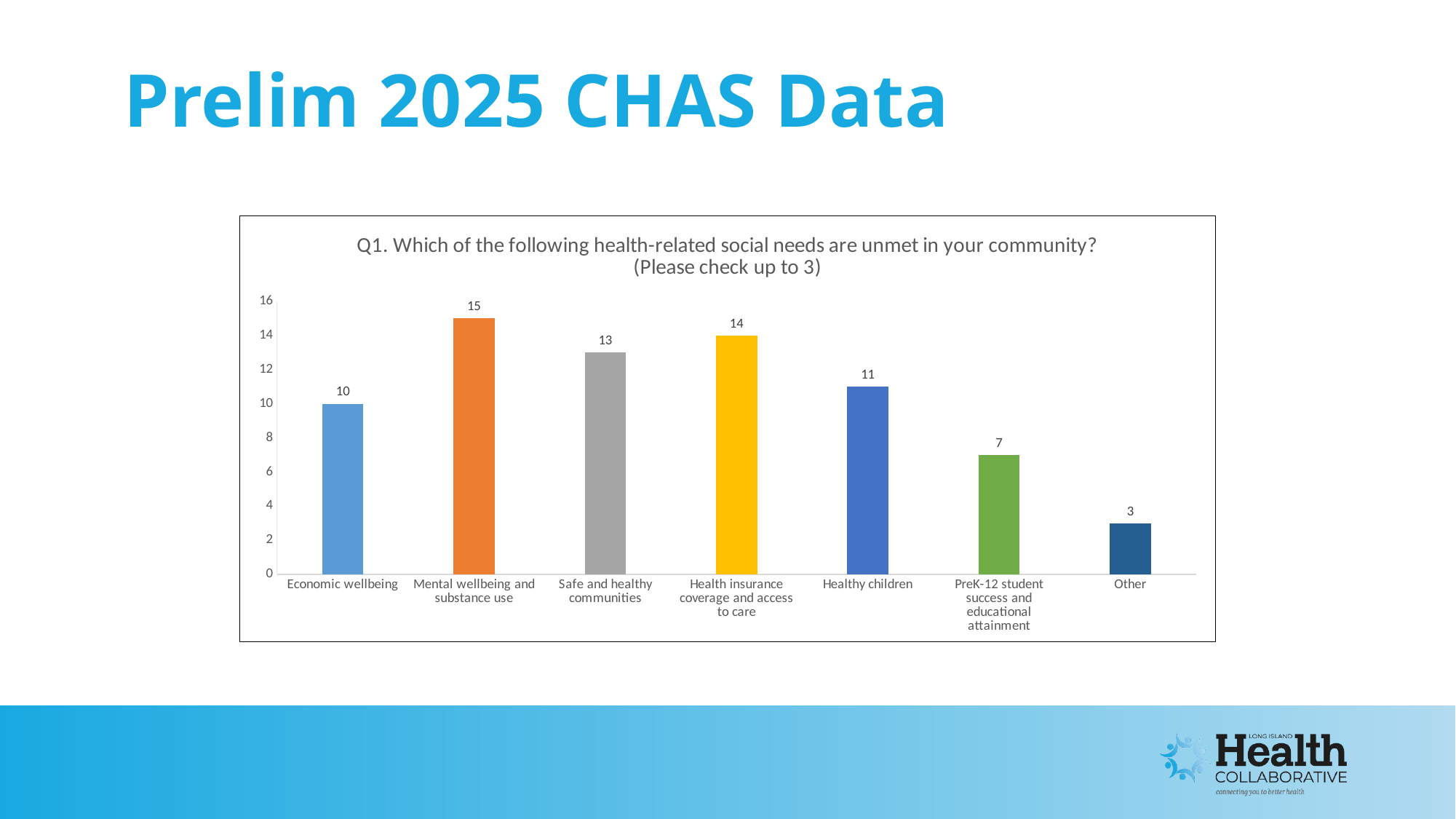
What is the value for Economic wellbeing? 10 What is the value for Mental wellbeing and substance use? 15 What is the title of the chart? Q1. Which of the following health-related social needs are unmet in your community? (Please check up to 3) What kind of chart is shown on the slide? Bar chart Which category has the lowest value? Other What is the value for Other? 3 Which is larger, the value for Healthy children or the value for PreK-12 student success and educational attainment? Healthy children How many categories are shown in the chart? 7 Is the value for Safe and healthy communities greater or less than 12? greater What is the value for Health insurance coverage and access to care? 14 Which category has the highest value? Mental wellbeing and substance use What is the difference between the values for Safe and healthy communities and Healthy children? 2